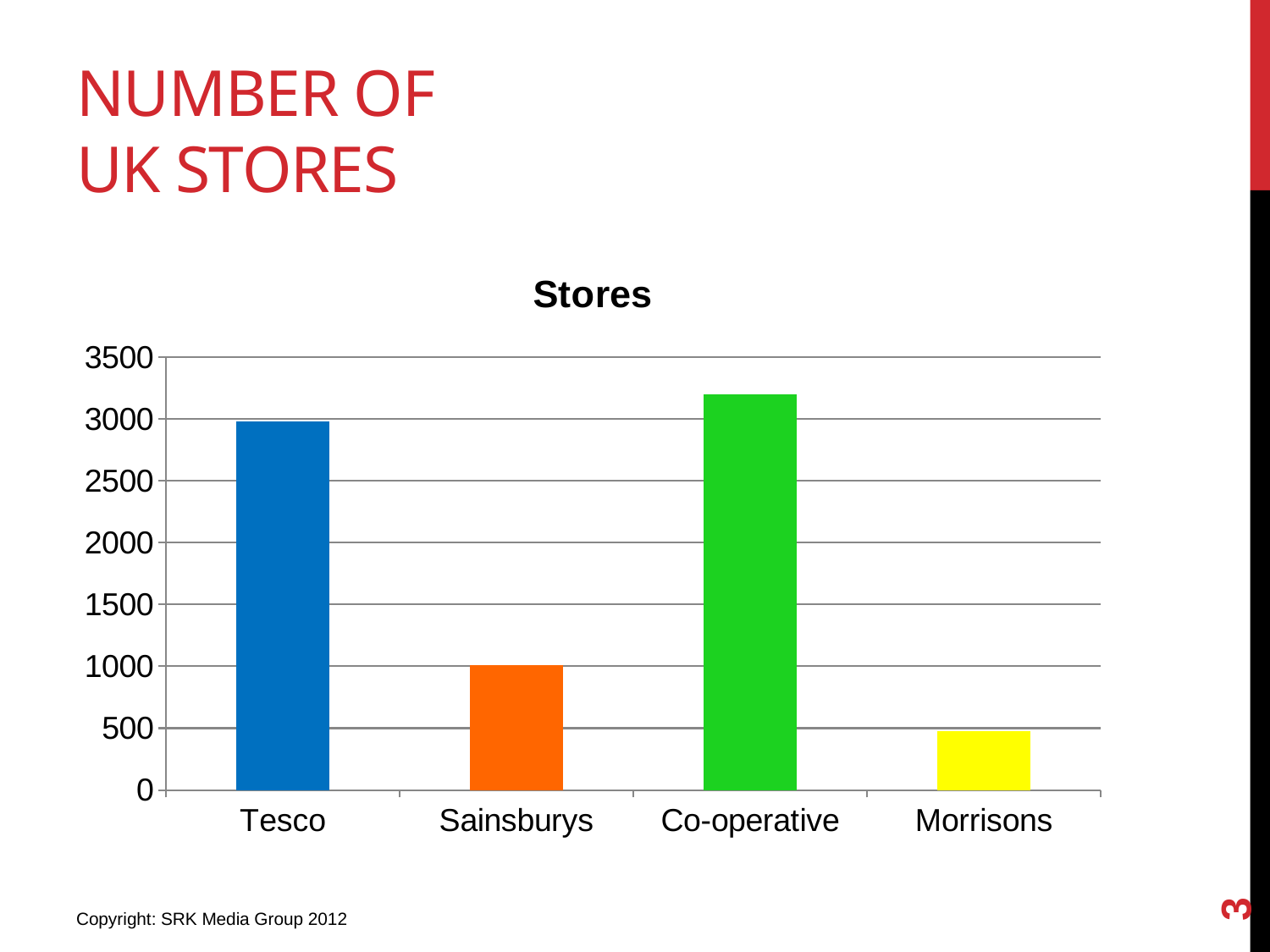
Which has more stores, Morrisons or Sainsburys? Sainsburys What colour is the bar for Co-operative? green Which has more stores, Tesco or Sainsburys? Tesco Is the value for Tesco greater or less than 2500? greater Is the value for Morrisons greater or less than 1000? less What is the title of the chart? Stores Which retailer has the highest number of stores? Co-operative What kind of chart is shown on the slide? bar chart How many retailers are shown on the x axis of the chart? 4 Which retailer has the lowest number of stores? Morrisons Is the value for Sainsburys greater or less than 1500? less